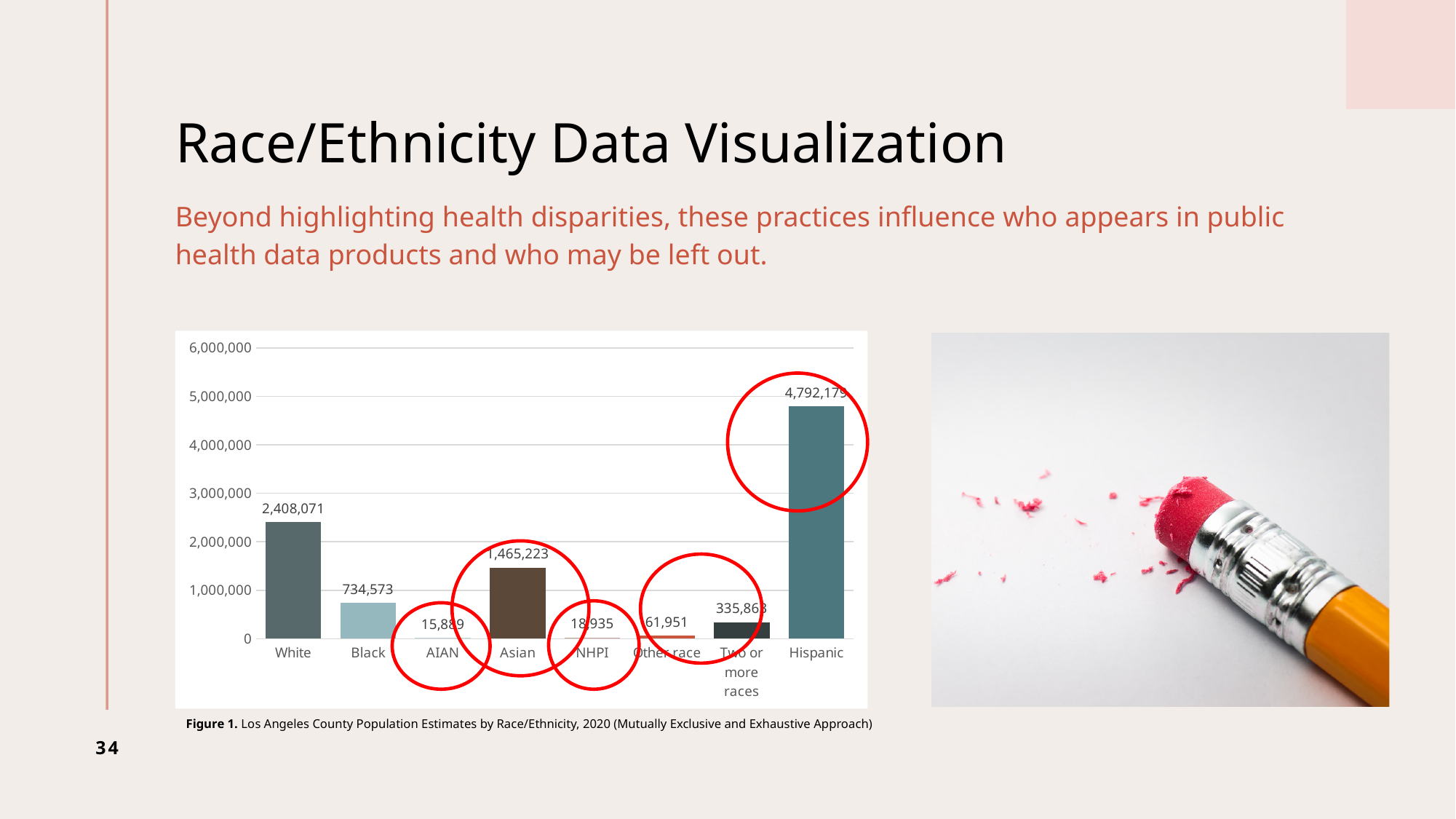
What is the difference between the White and Black population estimates? 1,673,498 What kind of chart is shown on the slide? bar chart Which category has the lowest population estimate? AIAN Is the value for Two or more races greater or less than 1,000,000? less Is the value for Hispanic greater or less than 4,000,000? greater Which is larger, the population estimate for Asian or for Black? Asian Which category has the highest population estimate? Hispanic What is the population estimate shown for White? 2,408,071 How many race/ethnicity categories are plotted in the chart? 8 What is the population estimate shown for Black? 734,573 What is the population estimate shown for Other race? 61,951 What is the population estimate shown for Asian? 1,465,223